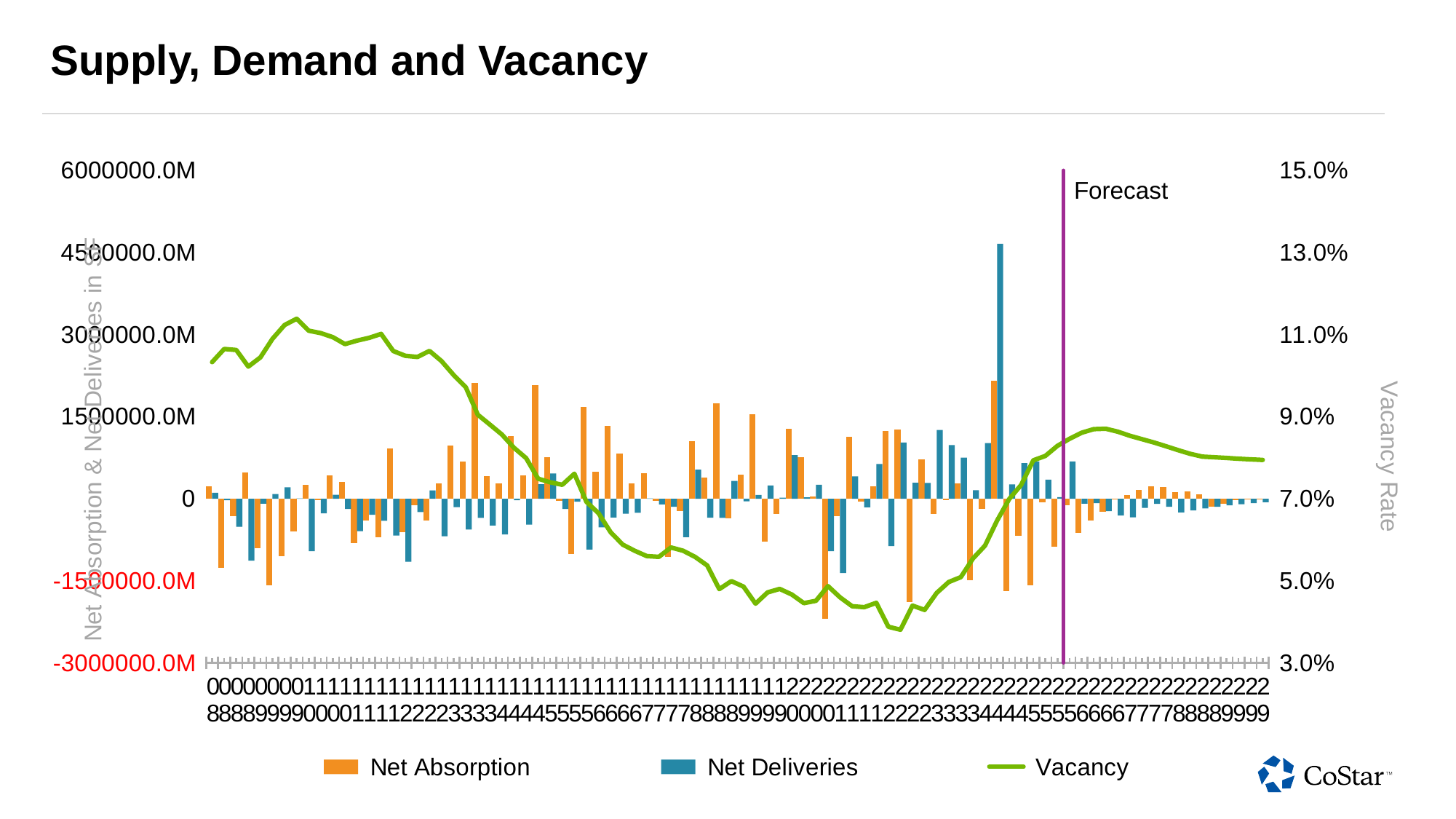
Is the Vacancy rate at the Forecast line greater or less than 7.0%? greater Is the lowest point of the Vacancy line greater or less than 5.0%? less What is the title of the chart? Supply, Demand and Vacancy Is the peak of the Vacancy line greater or less than 11.0%? greater What does the vertical purple line on the chart mark? Forecast Which series has the tallest positive bar on the chart, Net Absorption or Net Deliveries? Net Deliveries Does the Vacancy line rise or fall between its lowest point and the Forecast line? rise How many series does the legend list? 3 What kind of chart is this? Combined bar and line chart